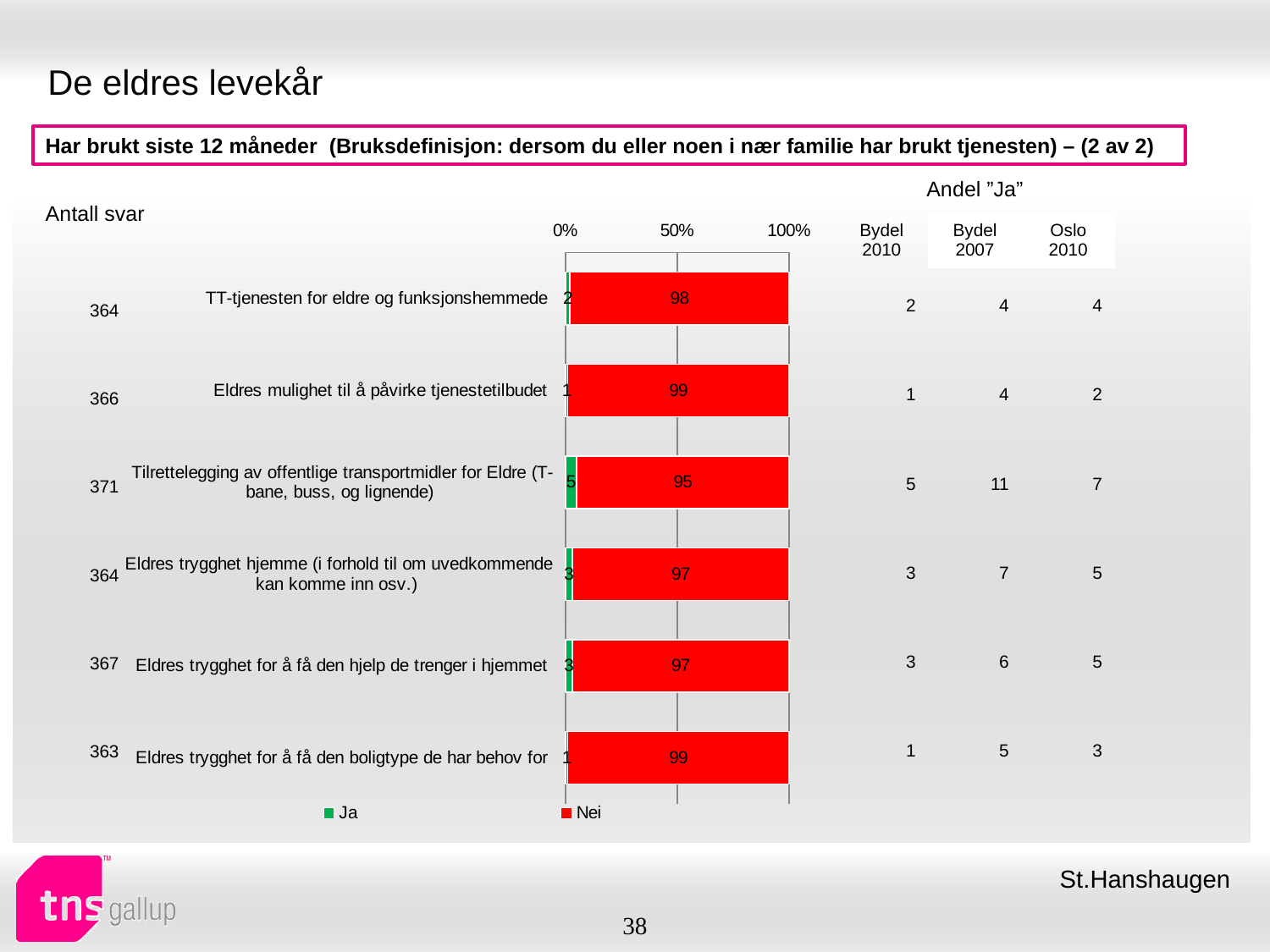
How many series does the chart legend list? 2 What are the two series named in the chart legend? Ja and Nei What is the difference between the Nei values for 'Eldres mulighet til å påvirke tjenestetilbudet' and 'Tilrettelegging av offentlige transportmidler for Eldre (T-bane, buss, og lignende)'? 4 Which category has the lowest Nei value? Tilrettelegging av offentlige transportmidler for Eldre (T-bane, buss, og lignende) Which is larger: the Nei value for 'TT-tjenesten for eldre og funksjonshemmede' or the Nei value for 'Eldres trygghet hjemme (i forhold til om uvedkommende kan komme inn osv.)'? TT-tjenesten for eldre og funksjonshemmede What is the Ja value for 'Tilrettelegging av offentlige transportmidler for Eldre (T-bane, buss, og lignende)'? 5 What type of chart is shown on the slide? bar chart What is the Nei value for 'Tilrettelegging av offentlige transportmidler for Eldre (T-bane, buss, og lignende)'? 95 What is the Nei value for 'Eldres trygghet for å få den hjelp de trenger i hjemmet'? 97 Is the Nei value for 'Eldres trygghet for å få den boligtype de har behov for' greater or less than 50%? greater How many categories are plotted in the chart? 6 What is the Nei value for 'TT-tjenesten for eldre og funksjonshemmede'? 98